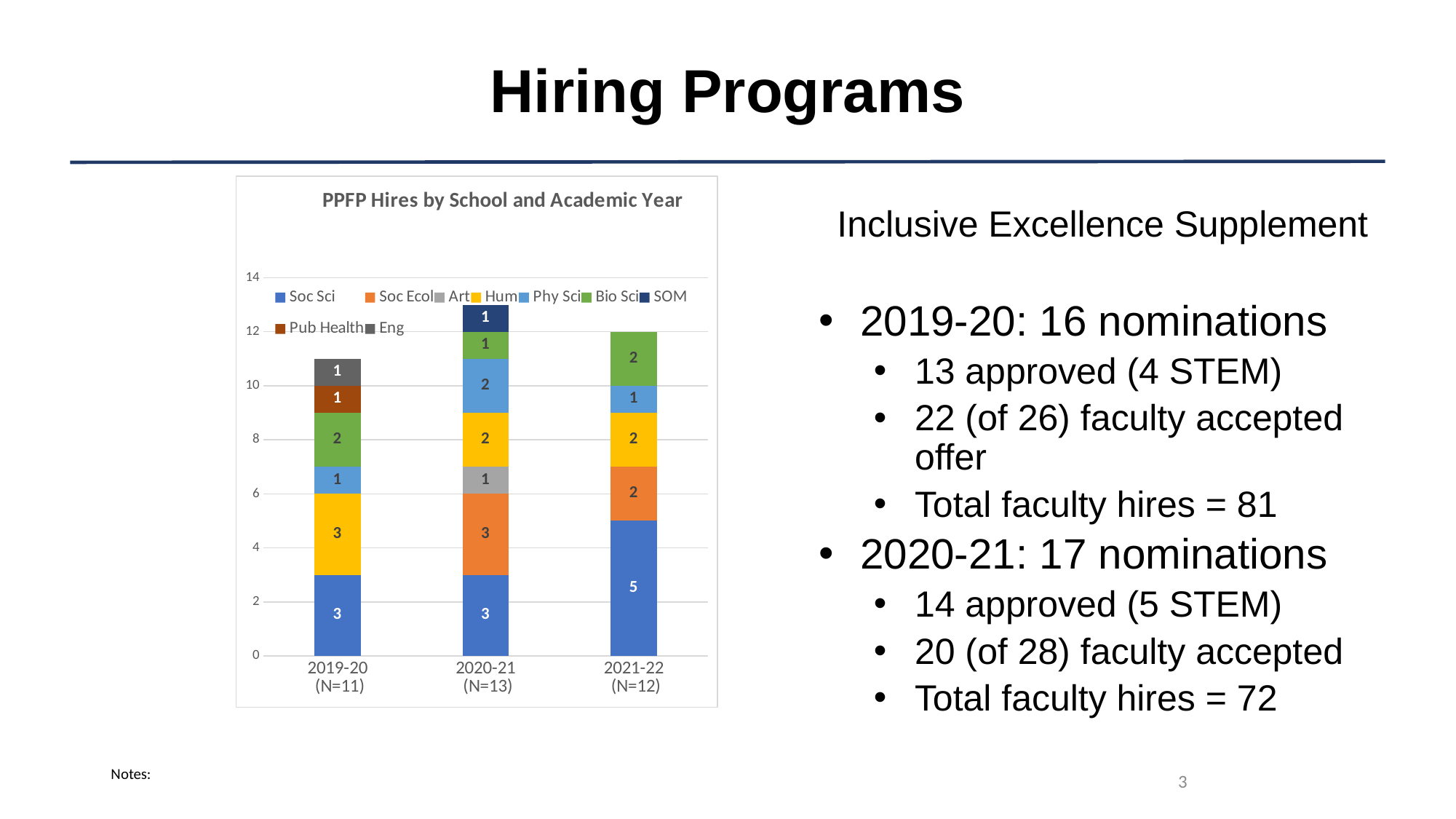
What is the total of the stacked bar for 2021-22? 12 What is the Hum value for 2019-20? 3 What is the Soc Ecol value for 2020-21? 3 How many series does the chart legend list? 9 What is the Soc Sci value for 2021-22? 5 What is the difference between the Soc Sci value for 2021-22 and the Soc Sci value for 2019-20? 2 Which academic year has the tallest stacked bar in total? 2020-21 (N=13) What is the title of the chart? PPFP Hires by School and Academic Year Which is larger, the Phy Sci value for 2020-21 or the Phy Sci value for 2021-22? 2020-21 What kind of chart is shown on the slide? Stacked bar chart Which academic year has the shortest stacked bar in total? 2019-20 (N=11) How many academic years are shown on the x axis? 3